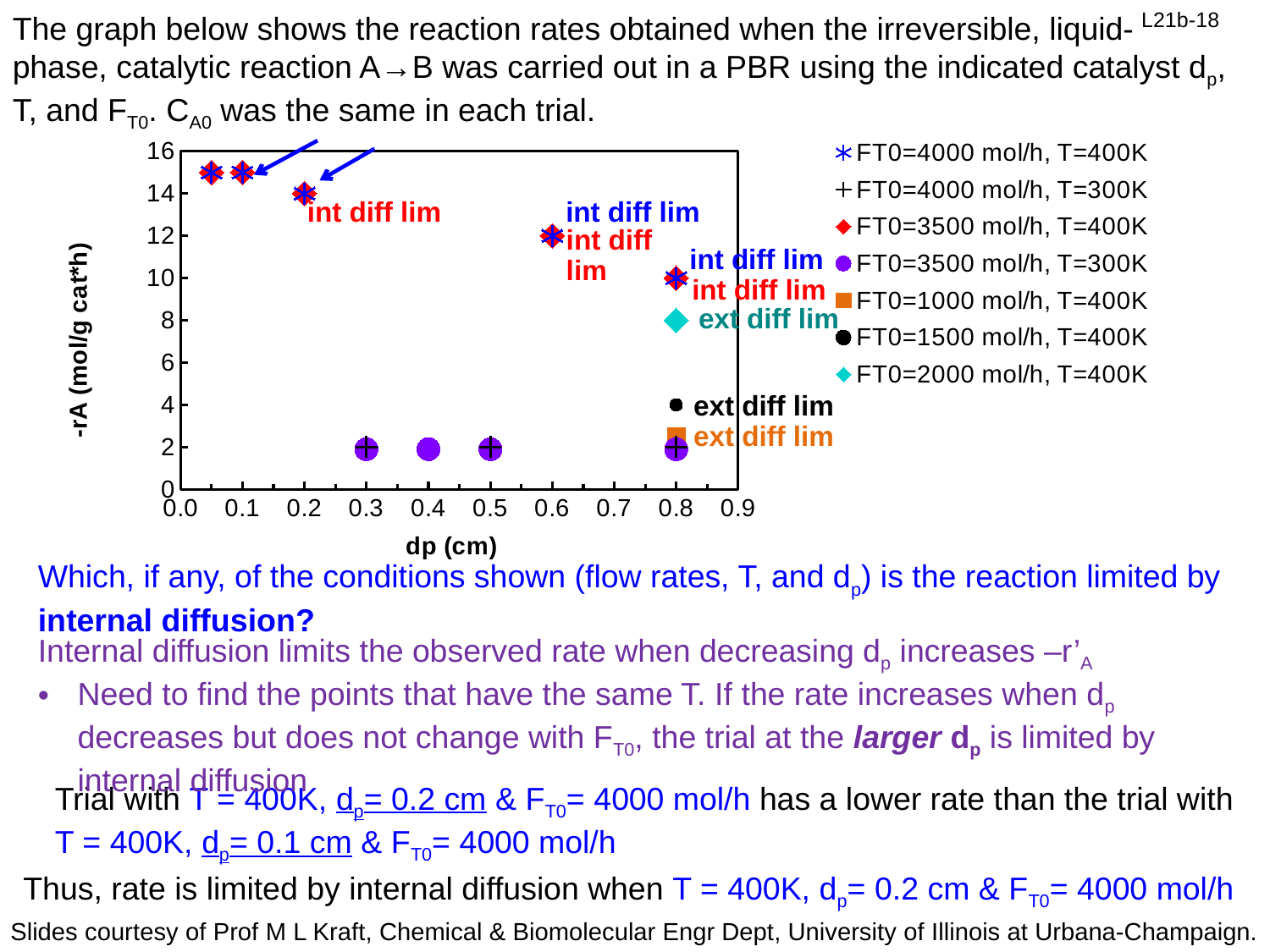
For the FT0=4000 mol/h, T=400K series, does the rate rise or fall as dp increases? fall Is the value for the T=300K points at dp = 0.4 cm greater or less than 4? less Is the value for the FT0=1500 mol/h, T=400K point greater or less than 6? less How many series does the chart legend list? 7 Is the value for the FT0=2000 mol/h, T=400K point greater or less than 6? greater At dp = 0.8 cm, which has the higher rate: the FT0=2000 mol/h, T=400K point or the FT0=1500 mol/h, T=400K point? FT0=2000 mol/h, T=400K For the FT0=4000 mol/h, T=400K series, which has the higher rate: dp = 0.6 cm or dp = 0.8 cm? dp = 0.6 cm What is the title of the x axis of the chart? dp (cm) At how many distinct dp values are T=300K points plotted? 4 What kind of chart is shown on the slide? scatter chart What is the title of the y axis of the chart? -rA (mol/g cat*h)